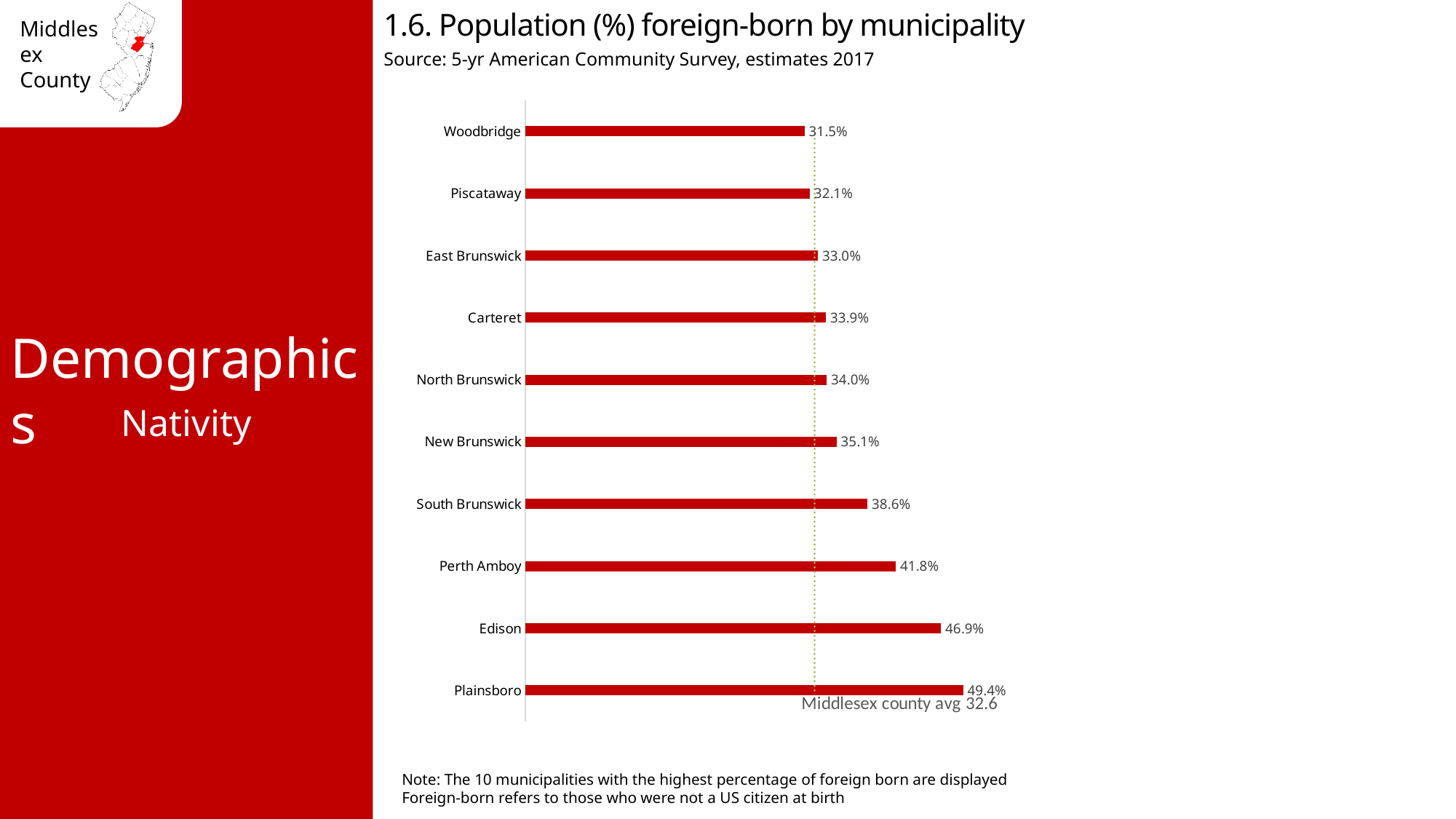
Which municipality has the highest percentage of foreign-born population? Plainsboro What kind of chart is shown on the slide? Bar chart Which has a higher foreign-born percentage, Carteret or Piscataway? Carteret What is the difference in foreign-born percentage between Perth Amboy and New Brunswick? 6.7% What is the Middlesex county average foreign-born percentage indicated by the dotted line? 32.6 What is the percentage of foreign-born population in Woodbridge? 31.5% What is the percentage of foreign-born population in South Brunswick? 38.6% What is the source of the data shown in the chart? 5-yr American Community Survey, estimates 2017 What is the difference in foreign-born percentage between Plainsboro and Edison? 2.5% Which municipality has the lowest percentage of foreign-born population shown on the chart? Woodbridge How many municipalities are shown on the chart? 10 What is the percentage of foreign-born population in Edison? 46.9%